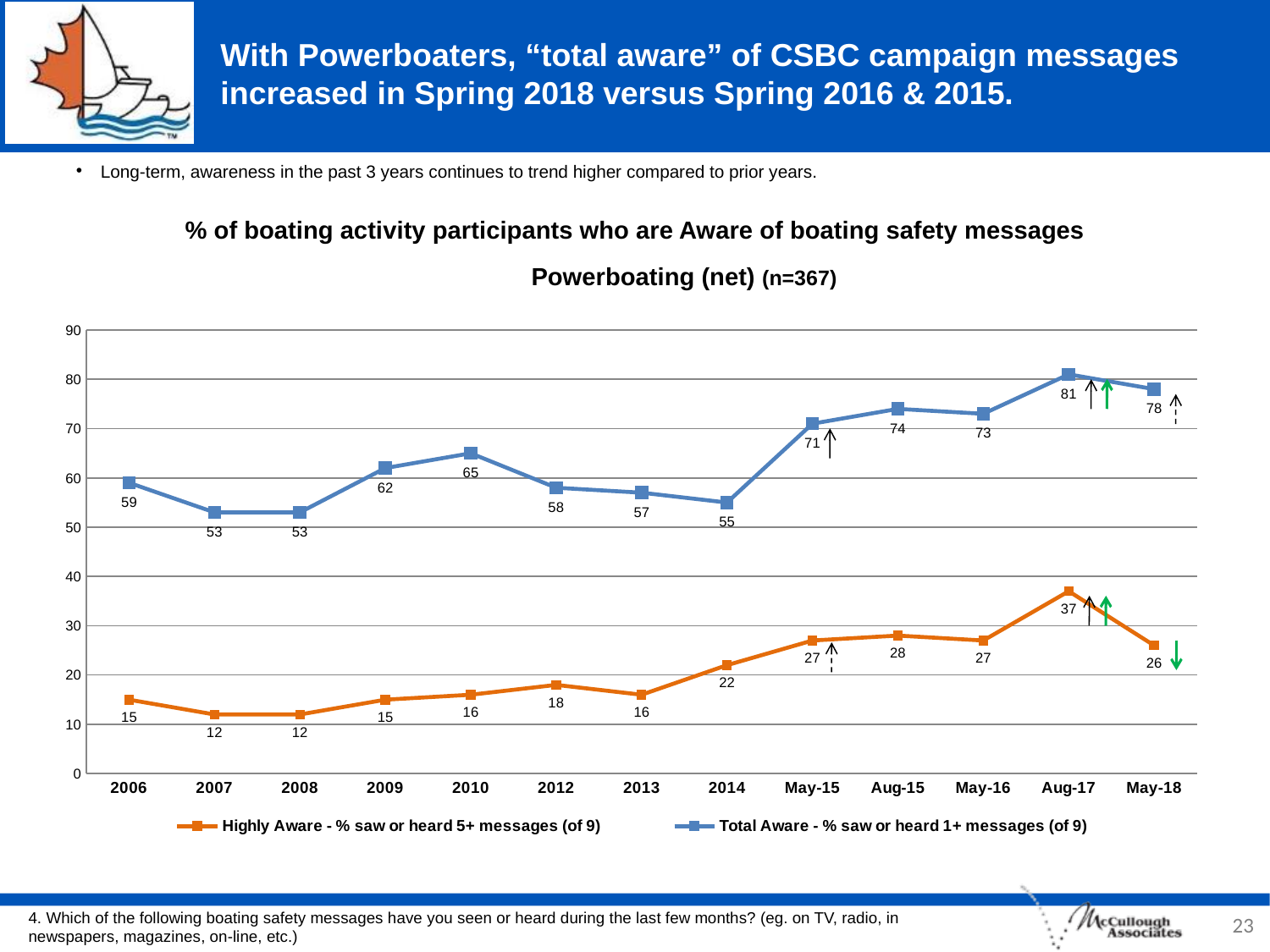
Does the Highly Aware series rise or fall from Aug-17 to May-18? Fall How many series does the legend list? 2 What type of chart is shown on the slide? Line chart What is the sample size (n) shown in the chart subtitle? n=367 What is the lowest value of the Highly Aware series? 12 How many time points are plotted along the x axis? 13 What is the difference between the Total Aware values for Aug-17 and May-18? 3 What is the Total Aware value for 2010? 65 What is the Total Aware value for Aug-17? 81 Which is larger, the Total Aware value for 2014 or for May-15? May-15 In which period is the Highly Aware series at its highest? Aug-17 What is the Highly Aware value for May-18? 26